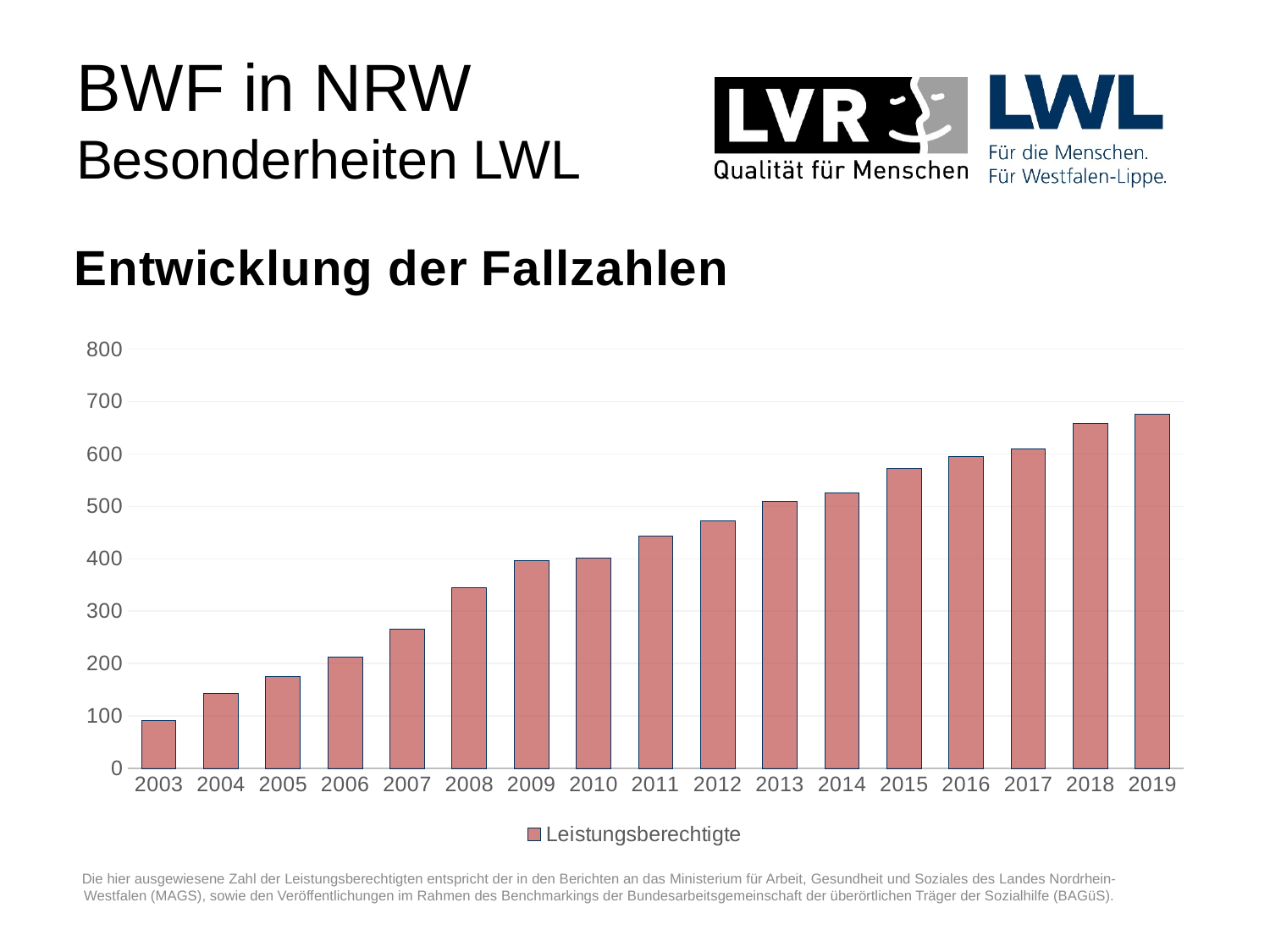
How many series does the legend list? 1 Is the value for 2008 greater or less than 300? greater What is the name of the series shown in the legend? Leistungsberechtigte Which year has the highest number of Leistungsberechtigte? 2019 What is the title above the chart? Entwicklung der Fallzahlen Is the value for 2003 greater or less than 100? less Do the values rise or fall from 2003 to 2019? rise What kind of chart is shown on the slide? bar chart Which year has the lowest number of Leistungsberechtigte? 2003 How many years are shown on the x axis of the chart? 17 Which year has the larger value, 2008 or 2013? 2013 Is the value for 2019 greater or less than 700? less